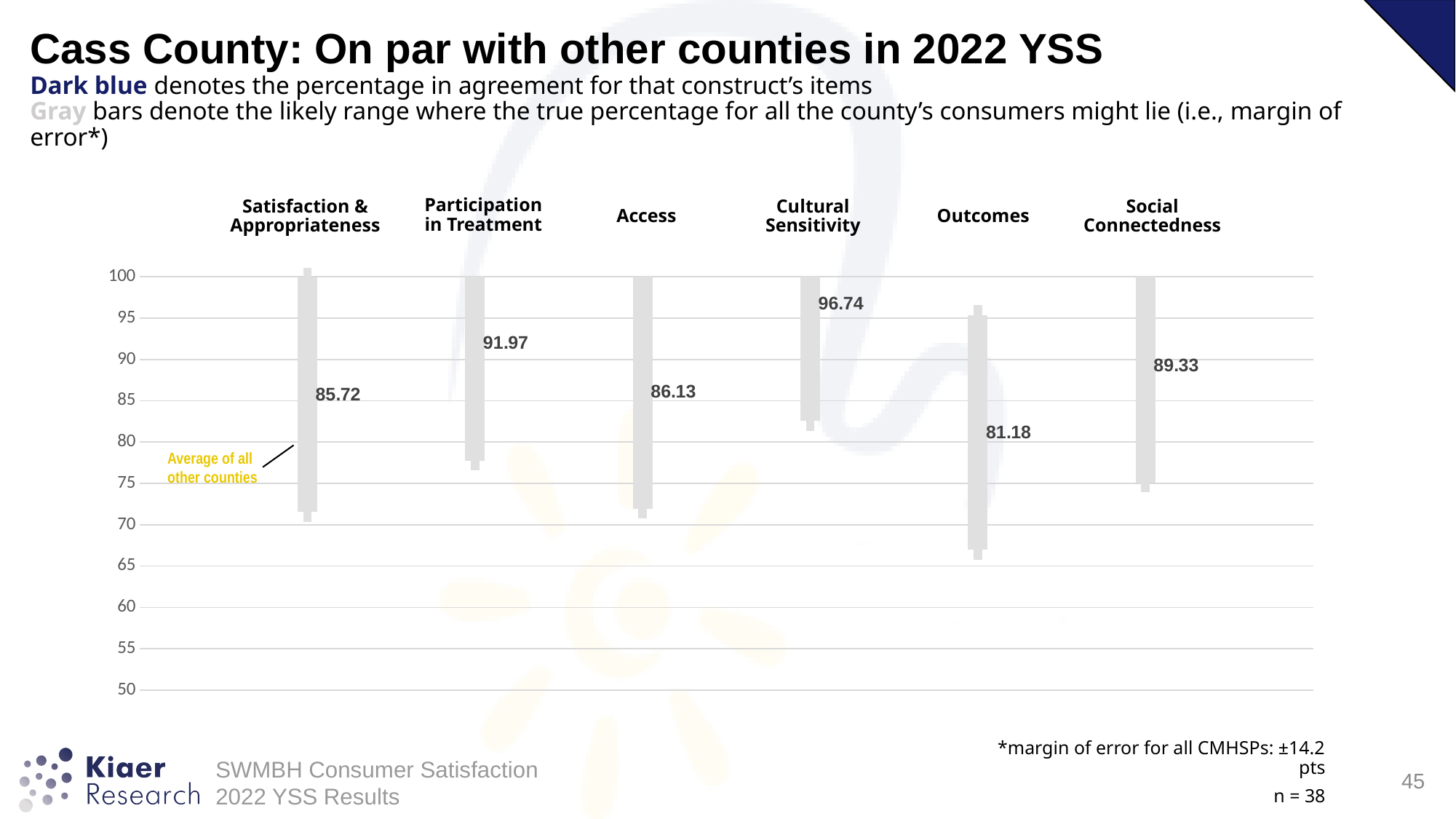
What value is labeled for Outcomes? 81.18 Which construct has the lowest labeled value? Outcomes What value is labeled for Cultural Sensitivity? 96.74 What is the difference between the labeled values for Cultural Sensitivity and Outcomes? 15.56 Is the labeled value for Outcomes greater or less than 85? less What value is labeled for Social Connectedness? 89.33 How many constructs are shown on the chart? 6 Which has a larger labeled value, Access or Satisfaction & Appropriateness? Access What is the difference between the labeled values for Participation in Treatment and Satisfaction & Appropriateness? 6.25 Which construct has the highest labeled value? Cultural Sensitivity What is the title of the slide? Cass County: On par with other counties in 2022 YSS What value is labeled for Participation in Treatment? 91.97